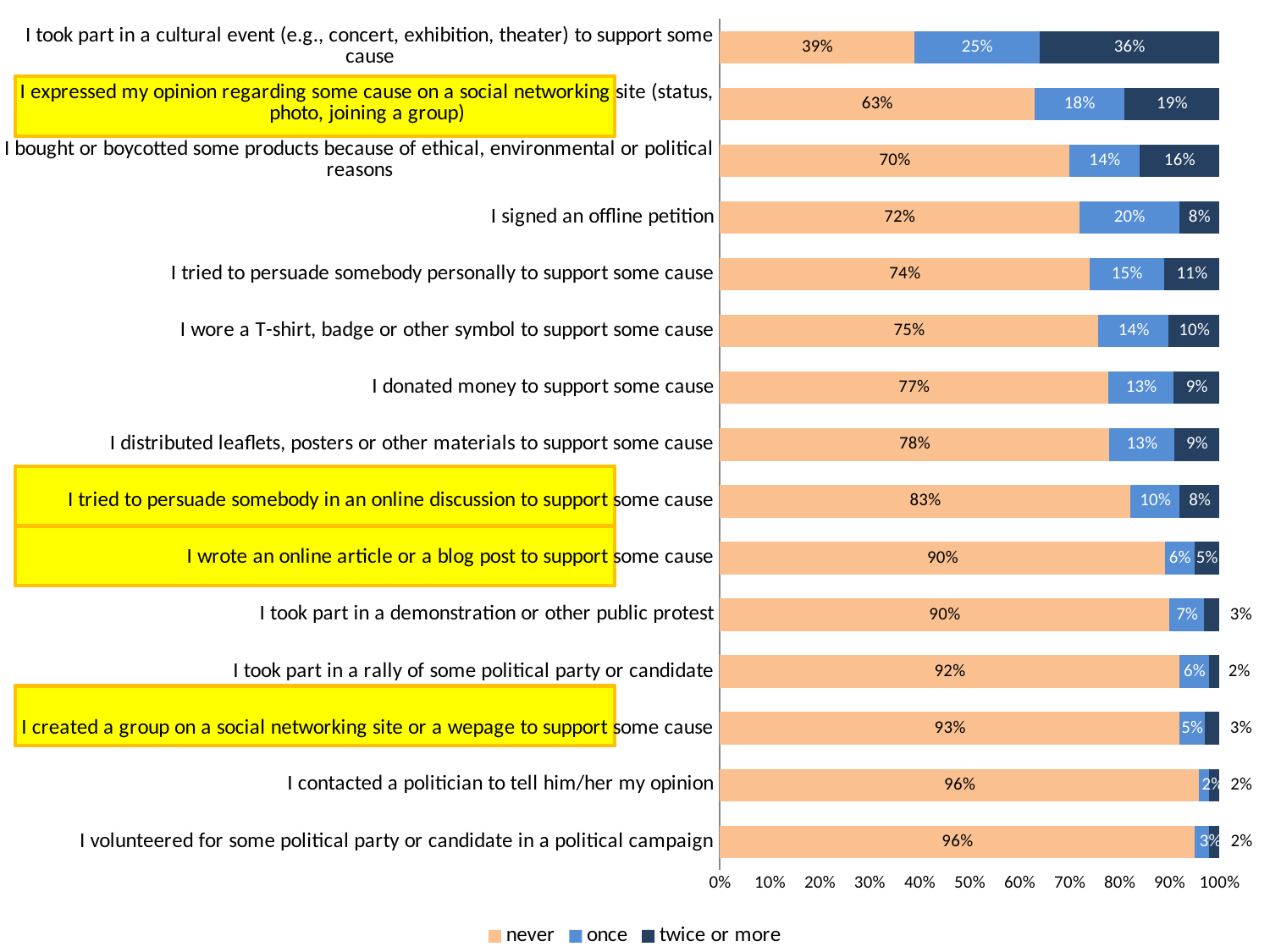
What type of chart is shown on the slide? Stacked bar chart What is the "once" value for "I expressed my opinion regarding some cause on a social networking site (status, photo, joining a group)"? 18% How many series does the legend list? 3 What percentage of respondents answered "never" for "I signed an offline petition"? 72% What is the total of the stacked bar for "I bought or boycotted some products because of ethical, environmental or political reasons"? 100% What are the three series named in the legend? never, once, twice or more What is the difference between the "never" values for "I donated money to support some cause" and "I signed an offline petition"? 5% Which activity has the highest "twice or more" percentage? I took part in a cultural event (e.g., concert, exhibition, theater) to support some cause How many activities (categories) are shown in the chart? 15 What is the "twice or more" value for "I took part in a cultural event (e.g., concert, exhibition, theater) to support some cause"? 36% Which activity has the lowest "never" percentage? I took part in a cultural event (e.g., concert, exhibition, theater) to support some cause Which has a larger "once" value: "I signed an offline petition" or "I tried to persuade somebody personally to support some cause"? I signed an offline petition